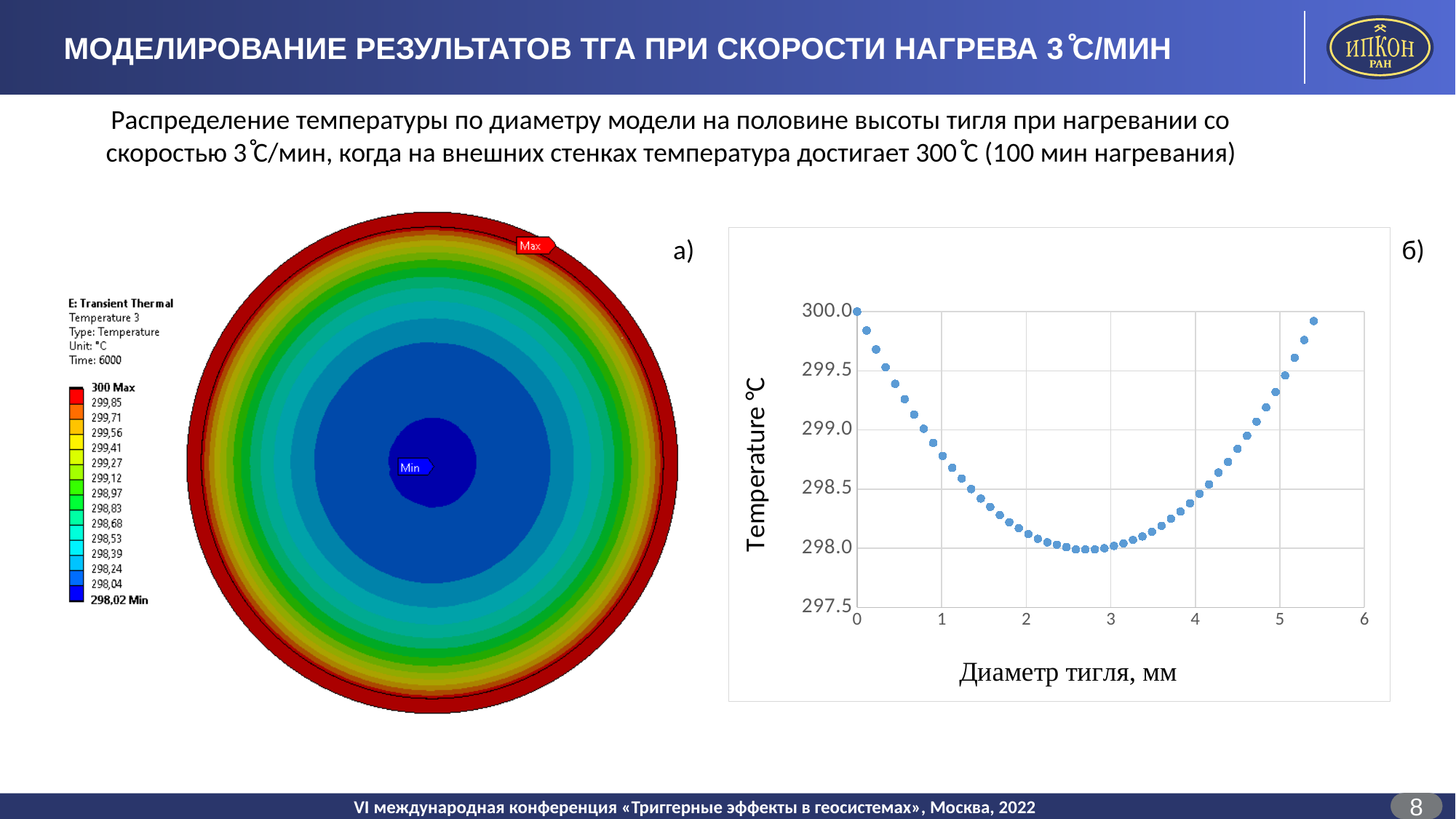
In chart б), which is larger: the temperature at 1 mm or at 5 mm? 5 mm In chart б), what is the title of the y axis? Temperature °C In chart б), what is the temperature at a diameter of 0 mm? 300.0 In chart б), is the lowest plotted temperature greater or less than 297.5? greater In chart б), do the temperature values rise or fall as the diameter goes from 0 mm to 2 mm? fall In chart б), do the temperature values rise or fall as the diameter goes from 4 mm to 5 mm? rise What kind of chart is chart б) on the right of the slide? scatter chart In chart б), what is the title of the x axis? Диаметр тигля, мм In chart б), is the temperature at a diameter of 3 mm greater or less than 298.5? less In chart б), is the temperature at a diameter of 1 mm greater or less than 299.0? less In chart б), which is larger: the temperature at 0 mm or at 3 mm? 0 mm